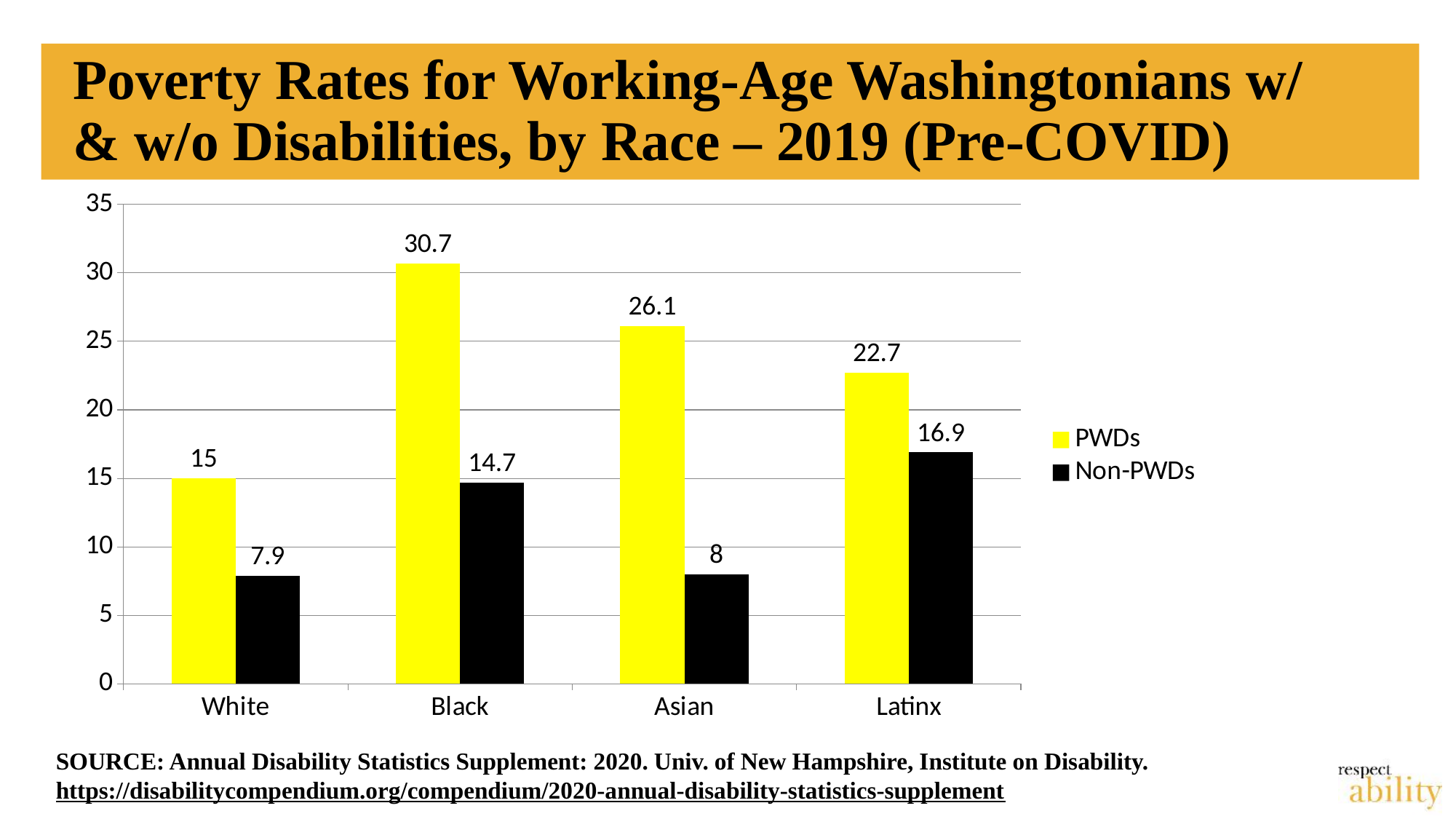
Which is larger, the Non-PWDs poverty rate for Black or for Latinx Washingtonians? Latinx What colour are the bars for PWDs? Yellow How many series does the legend list? 2 Which race has the highest poverty rate for PWDs? Black Is the poverty rate for White PWDs greater or less than 10? greater What is the poverty rate for Latinx Non-PWDs? 16.9 What kind of chart is shown on the slide? Bar chart What is the difference between the PWDs and Non-PWDs poverty rates for Asian Washingtonians? 18.1 How many race categories are shown on the x axis? 4 What is the poverty rate for Asian Non-PWDs? 8 What is the poverty rate for Black PWDs? 30.7 Which race has the lowest poverty rate for Non-PWDs? White